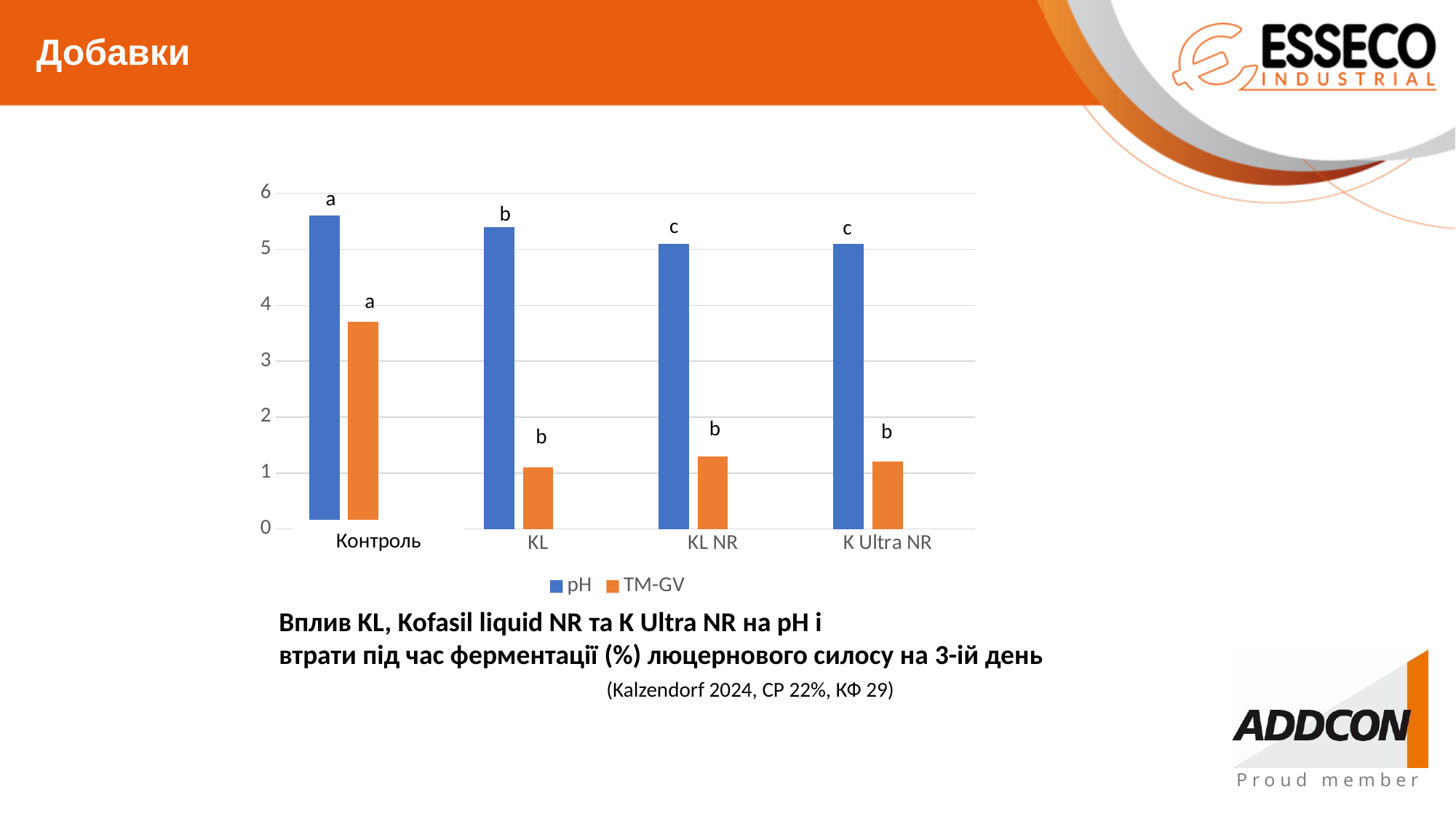
What are the two series named in the chart legend? pH and TM-GV Which has the larger TM-GV value: Контроль or KL? Контроль Which category has the highest pH value? Контроль How many categories are shown on the x axis of the chart? 4 Is the pH value for KL greater or less than 5? greater Which category has the highest TM-GV value? Контроль How many series does the chart legend list? 2 Is the TM-GV value for KL greater or less than 2? less Is the pH value for Контроль greater or less than 5? greater Which is larger for Контроль: the pH value or the TM-GV value? pH What kind of chart is shown on the slide? bar chart